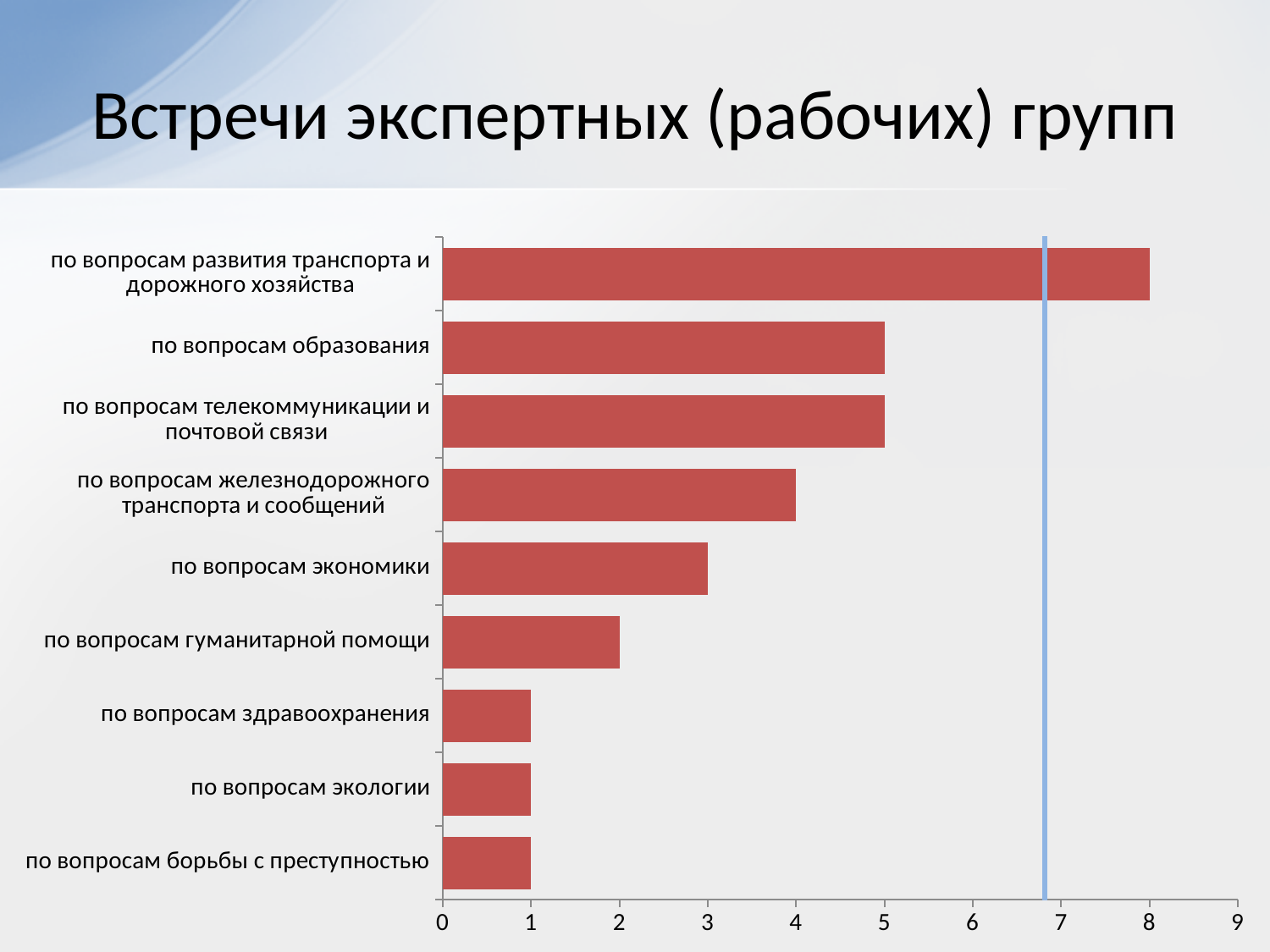
What is the title of the slide containing the chart? Встречи экспертных (рабочих) групп Is the value for "по вопросам образования" greater or less than 7? less What is the value for "по вопросам железнодорожного транспорта и сообщений"? 4 What is the value for "по вопросам гуманитарной помощи"? 2 What is the difference between the values for "по вопросам развития транспорта и дорожного хозяйства" and "по вопросам экономики"? 5 Which category has the highest value? по вопросам развития транспорта и дорожного хозяйства What is the value for "по вопросам образования"? 5 What kind of chart is shown on the slide? bar chart What is the value for "по вопросам развития транспорта и дорожного хозяйства"? 8 Which is larger: the value for "по вопросам телекоммуникации и почтовой связи" or the value for "по вопросам экономики"? по вопросам телекоммуникации и почтовой связи What is the value for "по вопросам экологии"? 1 How many categories are shown in the chart? 9